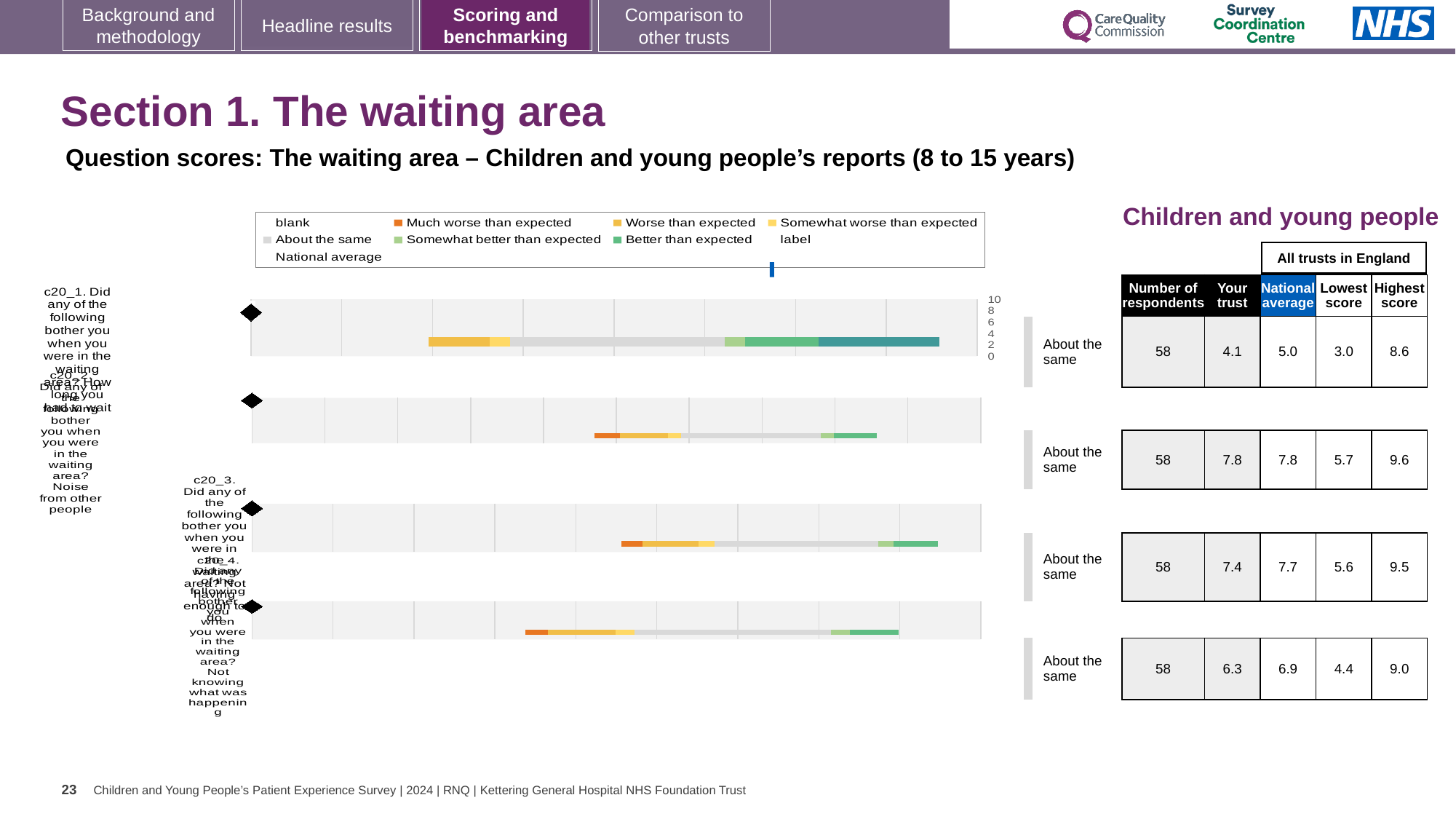
How many respondents answered each of the waiting area questions? 58 Which question has the highest 'Your trust' score? c20_2 (Noise from other people) Which question has the lowest 'Your trust' score? c20_1 For question c20_1, which is larger: the 'Your trust' score or the national average? National average What is the national average score for question c20_4 (Not knowing what was happening)? 6.9 What is the difference between the highest and lowest scores across all trusts for question c20_1? 5.6 What is the 'Your trust' score for question c20_2 (Noise from other people)? 7.8 How many questions (bars) are plotted in the waiting area chart? 4 What is the highest score among all trusts in England for question c20_2? 9.6 For question c20_3, what is the difference between the national average and the 'Your trust' score? 0.3 What benchmark category is shown for all four waiting area questions? About the same What kind of chart is used to show the question scores for the waiting area? bar chart